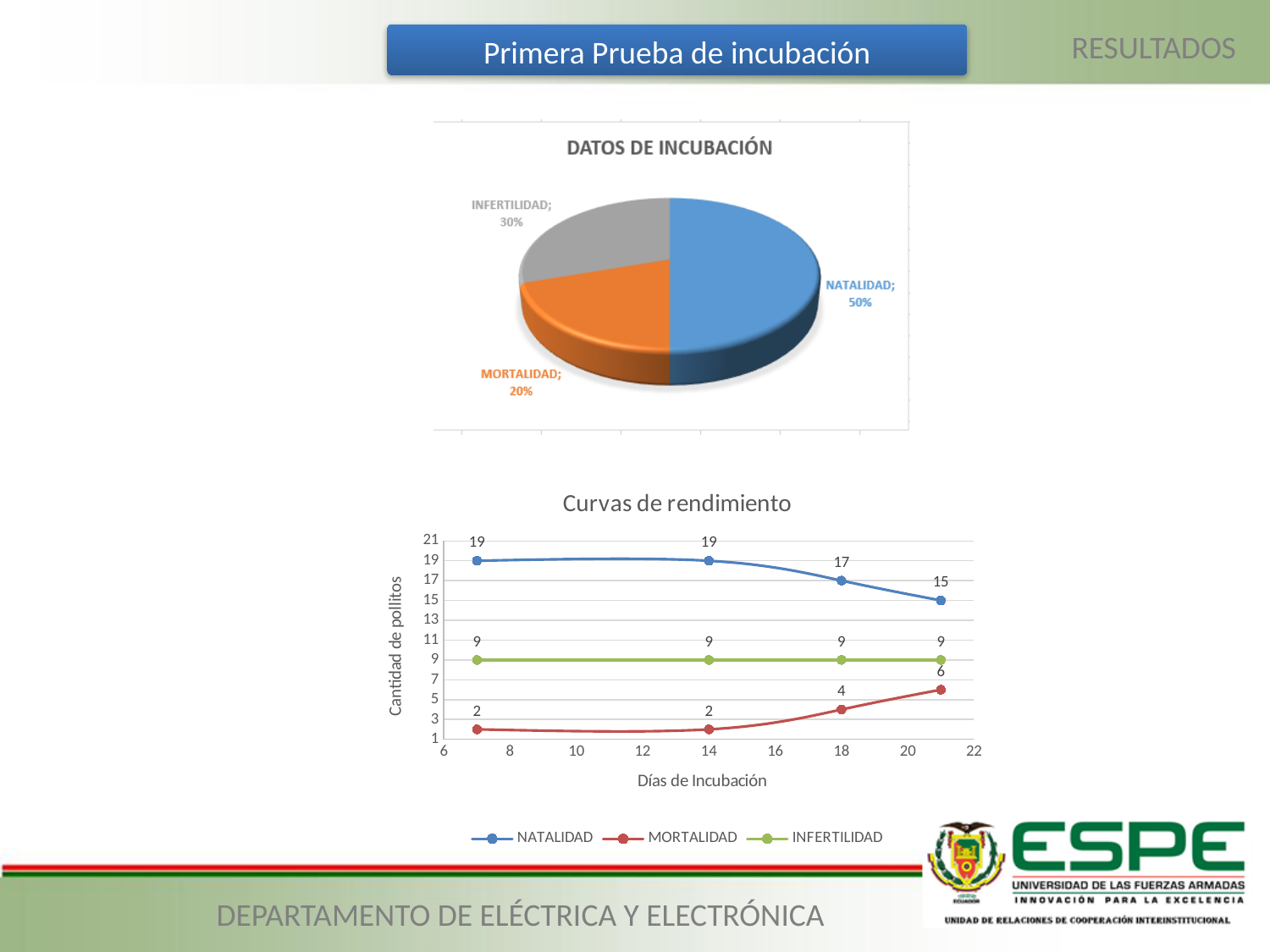
In the DATOS DE INCUBACIÓN pie chart, which category has the largest slice? NATALIDAD In the DATOS DE INCUBACIÓN pie chart, which category has the smallest slice? MORTALIDAD In the Curvas de rendimiento chart, what is the difference between the NATALIDAD and INFERTILIDAD values at 18 days? 8 In the Curvas de rendimiento chart, what is the NATALIDAD value at 14 days of incubation? 19 In the DATOS DE INCUBACIÓN pie chart, what share does MORTALIDAD have? 20% In the Curvas de rendimiento chart, what is the MORTALIDAD value at 18 days of incubation? 4 In the Curvas de rendimiento chart, does the MORTALIDAD series rise or fall along the x axis? Rises In the DATOS DE INCUBACIÓN pie chart, how many slices are there? 3 In the Curvas de rendimiento chart, how many series does the legend list? 3 In the Curvas de rendimiento chart, what is the last plotted NATALIDAD value? 15 In the DATOS DE INCUBACIÓN pie chart, what share does NATALIDAD have? 50% What kind of chart is DATOS DE INCUBACIÓN? Pie chart